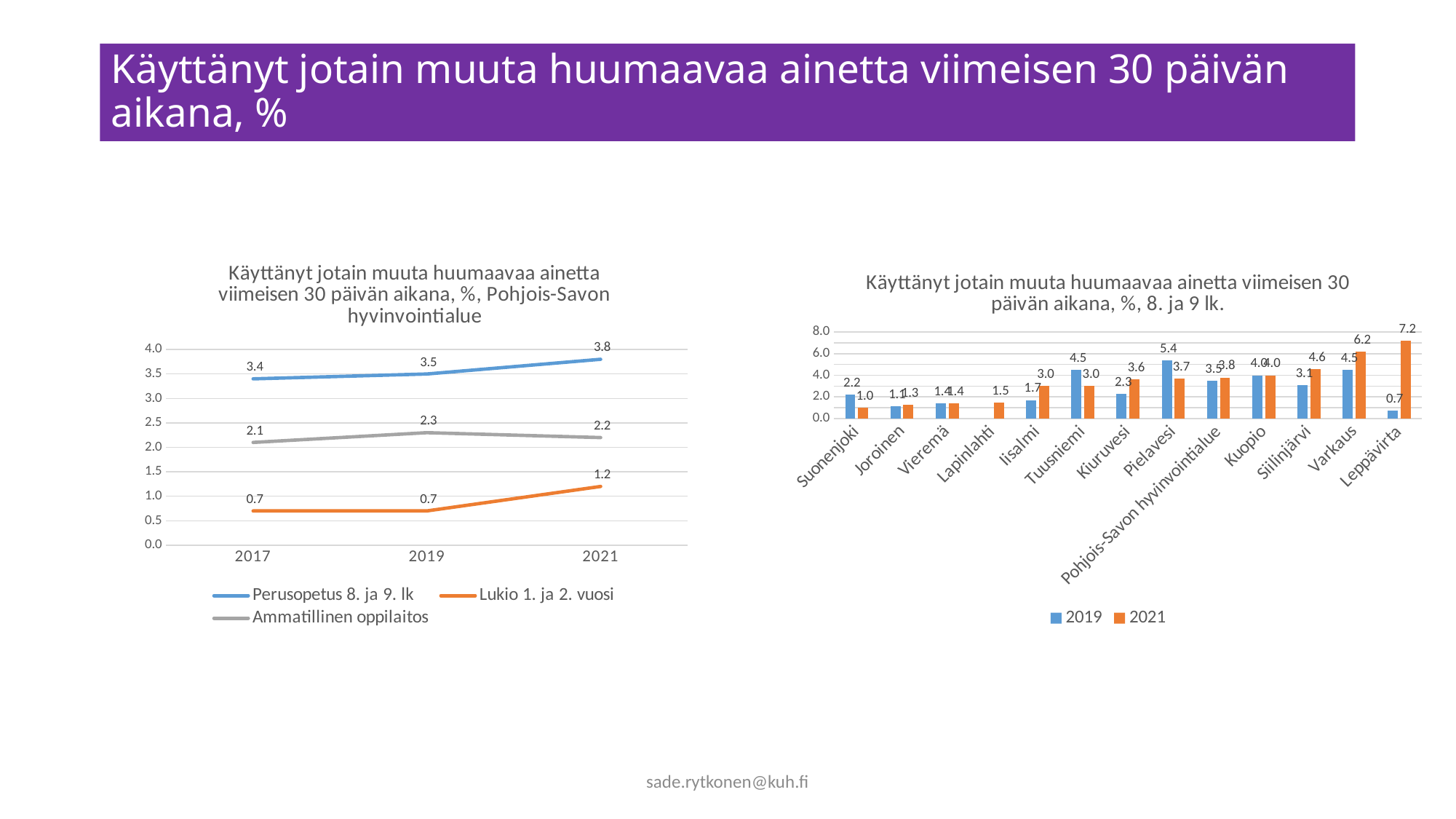
On the left line chart (Pohjois-Savon hyvinvointialue), does the Perusopetus 8. ja 9. lk line rise or fall from 2017 to 2021? rise On the left line chart (Pohjois-Savon hyvinvointialue), what is the value for Perusopetus 8. ja 9. lk in 2021? 3.8 On the left line chart (Pohjois-Savon hyvinvointialue), what is the value for Ammatillinen oppilaitos in 2017? 2.1 On the right chart (8. ja 9 lk.), what kind of chart is shown? bar chart On the left line chart (Pohjois-Savon hyvinvointialue), what is the value for Lukio 1. ja 2. vuosi in 2019? 0.7 On the right chart (8. ja 9 lk.), what is the 2019 value for Pielavesi? 5.4 On the right chart (8. ja 9 lk.), what is the 2021 value for Leppävirta? 7.2 On the right chart (8. ja 9 lk.), which category has the lowest 2019 value? Leppävirta On the left line chart (Pohjois-Savon hyvinvointialue), what is the difference between the Perusopetus 8. ja 9. lk value and the Lukio 1. ja 2. vuosi value in 2021? 2.6 On the right chart (8. ja 9 lk.), which is larger for Varkaus: the 2019 value or the 2021 value? 2021 On the right chart (8. ja 9 lk.), which category has the highest 2021 value? Leppävirta On the left line chart (Pohjois-Savon hyvinvointialue), how many series does the legend list? 3